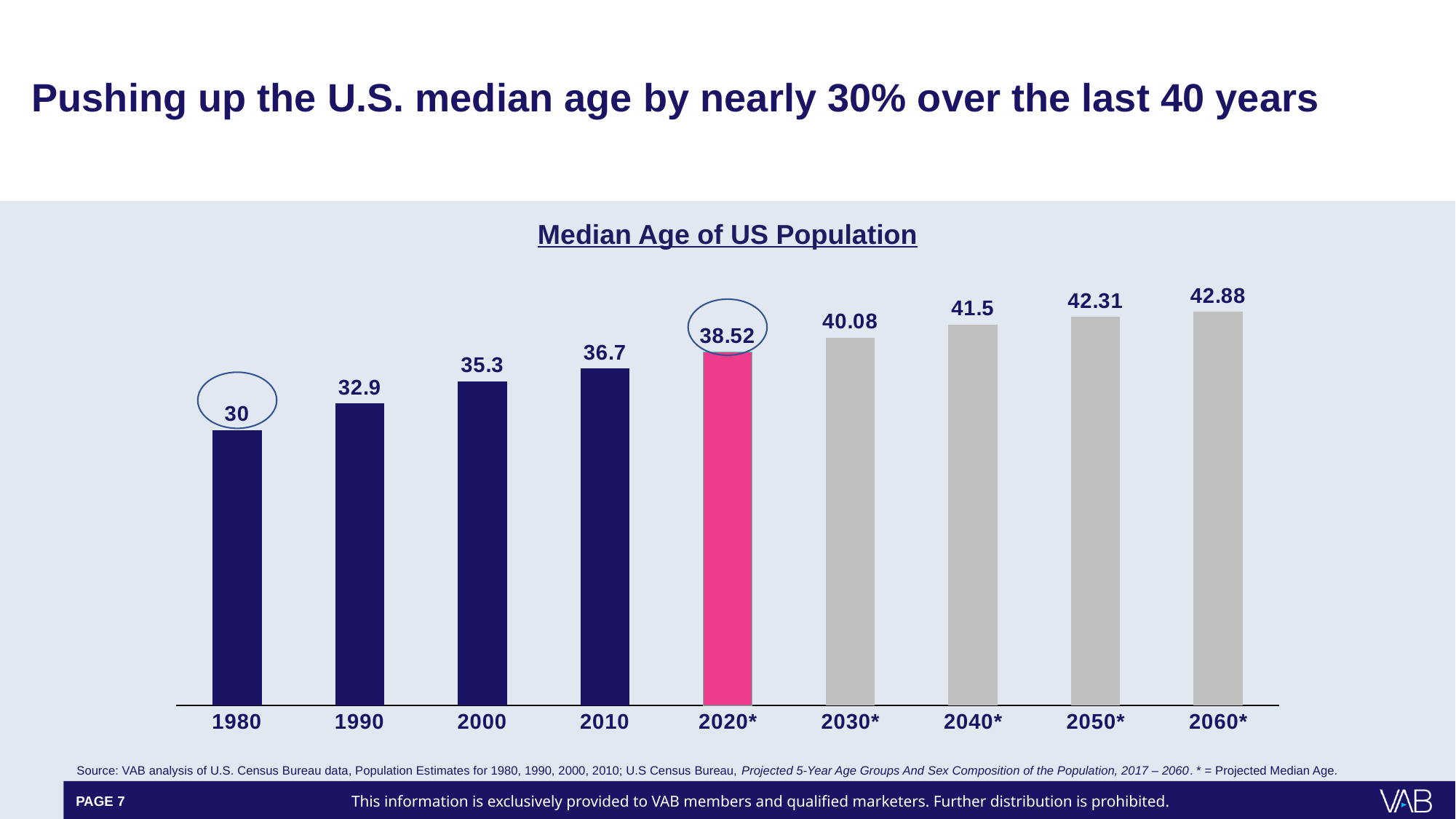
What is the difference between the median age in 2020* and in 1980? 8.52 Which year has the lowest median age on the chart? 1980 What is the projected median age shown for 2060*? 42.88 Do the median age values rise or fall from 1980 to 2060*? Rise Which year has the highest median age on the chart? 2060* What kind of chart is shown on the slide? Bar chart What is the difference between the median age in 2010 and in 1990? 3.8 Which is larger, the median age for 2030* or for 2010? 2030* What is the median age shown for 2020*? 38.52 What is the median age shown for 2000? 35.3 How many years (bars) are shown on the chart? 9 What is the median age of the US population shown for 1980? 30